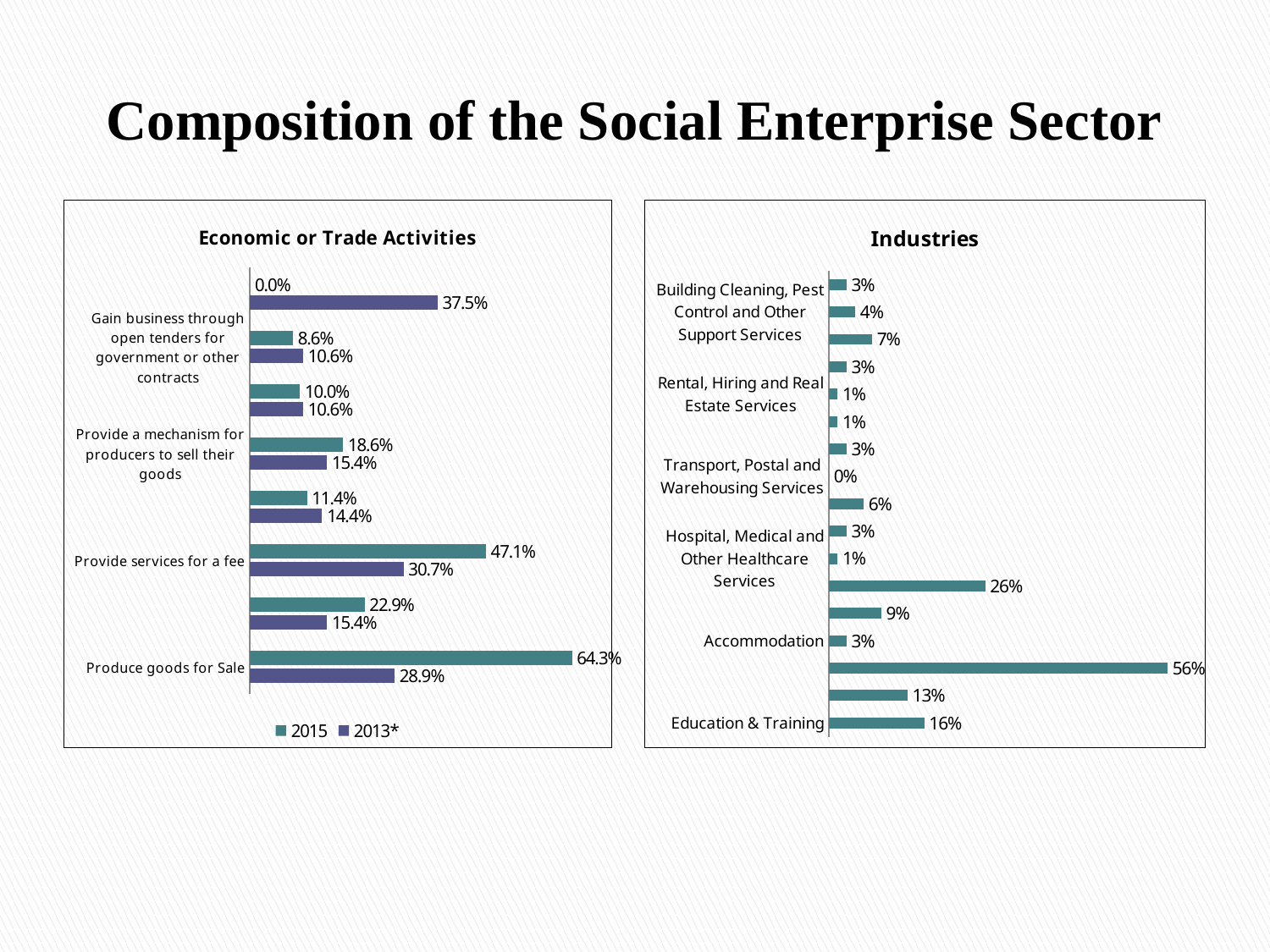
In the Economic or Trade Activities chart, which is larger for Provide services for a fee: the 2015 value or the 2013* value? 2015 In the Industries chart, what is the value shown next to the Education & Training label? 16% In the Economic or Trade Activities chart, what is the 2013* value for Provide services for a fee? 30.7% What are the two series named in the legend of the Economic or Trade Activities chart? 2015 and 2013* In the Industries chart, what is the highest value shown? 56% What kind of chart is the Industries chart? Bar chart In the Economic or Trade Activities chart, which series has the higher value for Produce goods for Sale? 2015 In the Economic or Trade Activities chart, what is the 2013* value for Produce goods for Sale? 28.9% How many series does the legend of the Economic or Trade Activities chart list? 2 In the Economic or Trade Activities chart, what is the difference between the 2015 and 2013* values for Produce goods for Sale? 35.4% In the Economic or Trade Activities chart, what is the 2015 value for Provide services for a fee? 47.1% In the Economic or Trade Activities chart, what is the 2015 value for Produce goods for Sale? 64.3%